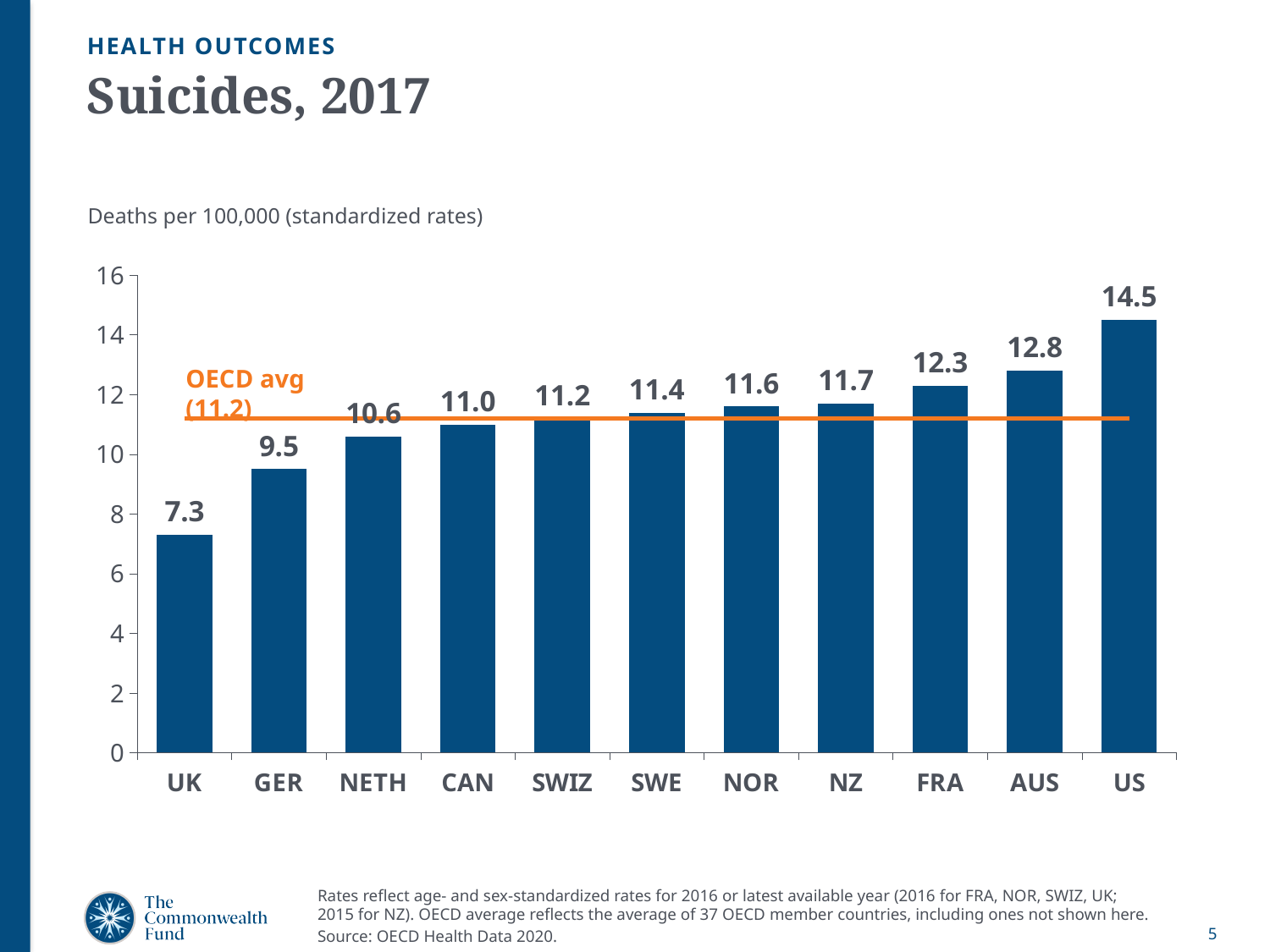
What is the difference between the values for FRA and CAN? 1.3 What is the value shown for NOR? 11.6 How many countries are shown on the chart? 11 What is the suicide rate shown for the US? 14.5 What is the difference between the values for the US and the UK? 7.2 Do the values rise or fall from left to right across the countries? Rise Which country has the highest suicide rate on the chart? US Which has a higher value, AUS or NETH? AUS What OECD average value is marked by the orange line? 11.2 What kind of chart is shown on the slide? Bar chart Which country has the lowest suicide rate on the chart? UK What is the value shown for GER? 9.5